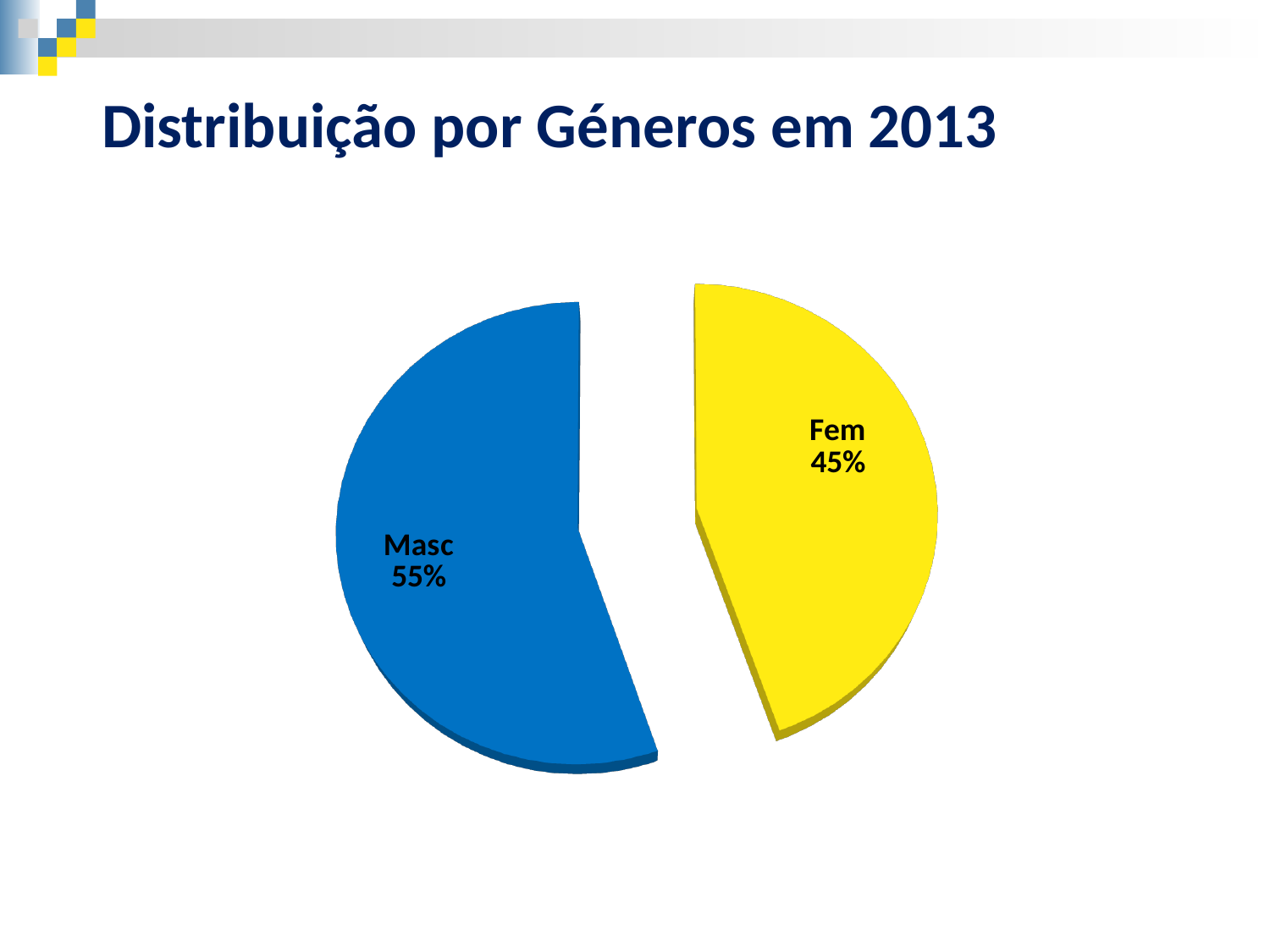
How many slices does the pie chart have? 2 Which slice is larger, Masc or Fem? Masc Which category has the smallest slice of the pie? Fem What colour is the Fem slice? Yellow What kind of chart is shown on the slide? Pie chart What share of the pie does Fem represent? 45% Which category has the largest slice of the pie? Masc What share of the pie does Masc represent? 55% What is the difference in percentage points between the Masc and Fem slices? 10 What is the title of the slide? Distribuição por Géneros em 2013